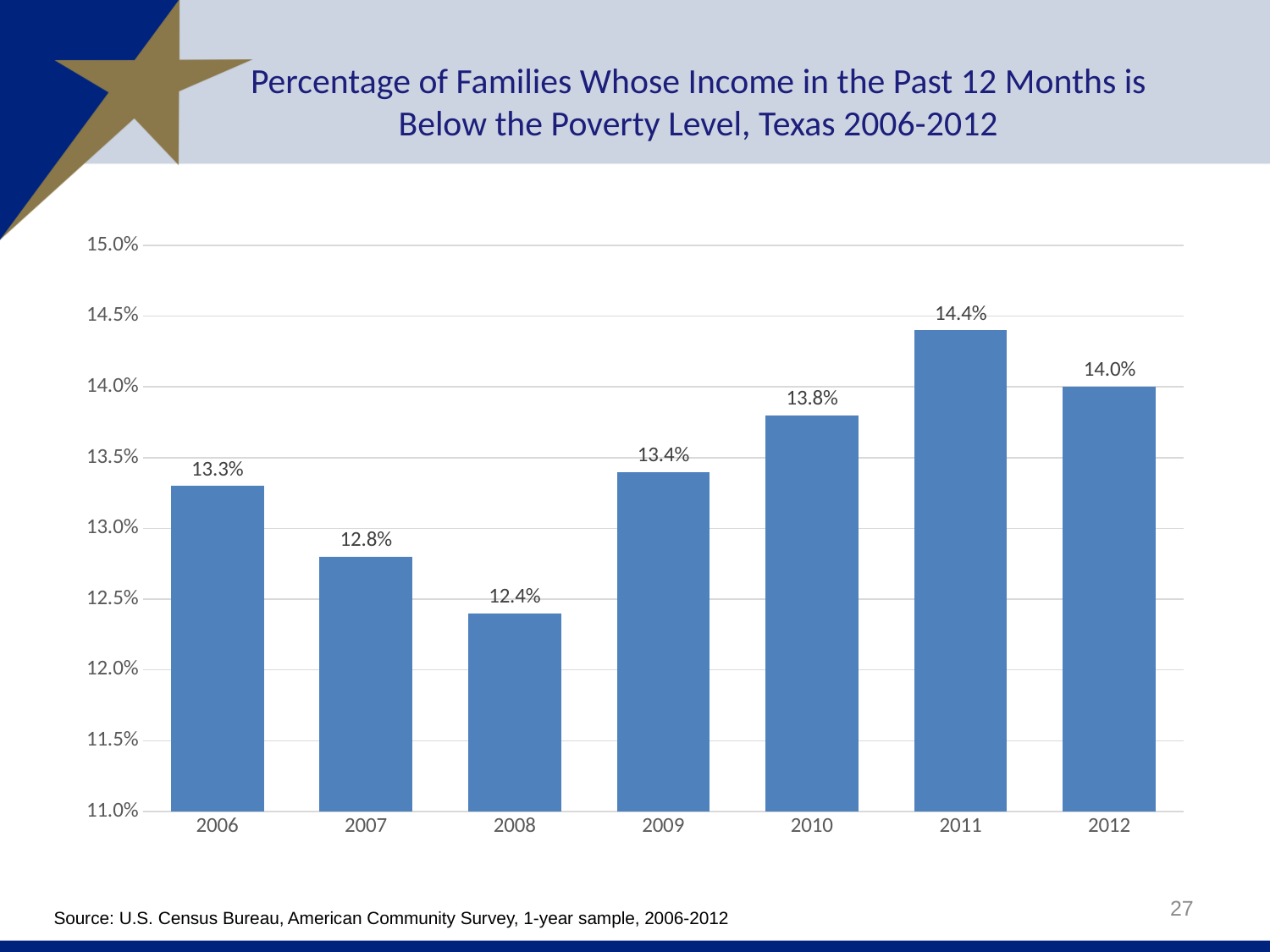
What is the value for 2011? 14.4% Which year has the highest value? 2011 What is the difference between the values for 2012 and 2006? 0.7% Is the value for 2009 greater or less than 13.0%? greater What is the value for 2008? 12.4% What is the value for 2006? 13.3% What kind of chart is this? bar chart Do the values rise or fall from 2008 to 2011? rise Which is larger, the value for 2010 or the value for 2012? 2012 What is the difference between the values for 2011 and 2008? 2.0% How many years are shown on the x axis? 7 Which year has the lowest value? 2008